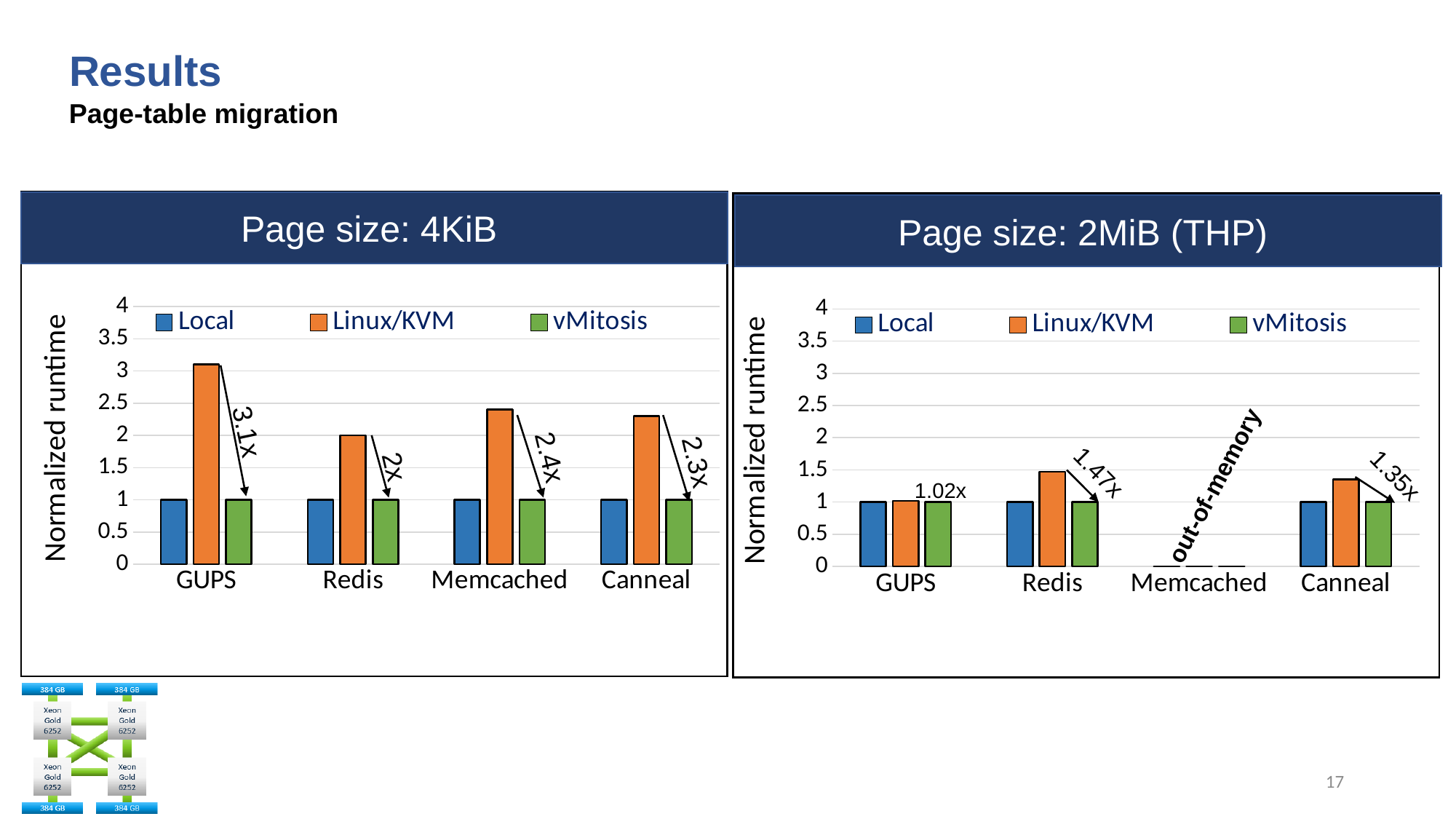
In the 'Page size: 2MiB (THP)' chart, which has the larger Linux/KVM normalized runtime, Redis or Canneal? Redis In the 'Page size: 4KiB' chart, how many series does the legend list? 3 In the 'Page size: 2MiB (THP)' chart, which category is marked 'out-of-memory' with no bars? Memcached In the 'Page size: 4KiB' chart, which category has the highest Linux/KVM normalized runtime? GUPS In the 'Page size: 4KiB' chart, is the Linux/KVM value for Memcached greater or less than 2? greater In the 'Page size: 4KiB' chart, what is the Local normalized runtime for GUPS? 1 In the 'Page size: 4KiB' chart, which category has the lowest Linux/KVM normalized runtime? Redis In the 'Page size: 4KiB' chart, what is the Linux/KVM normalized runtime for Redis? 2 What kind of chart is shown in the 'Page size: 4KiB' panel? bar chart In the 'Page size: 2MiB (THP)' chart, how many categories are shown on the x axis? 4 In the 'Page size: 2MiB (THP)' chart, is the Linux/KVM value for Canneal greater or less than 1.5? less In the 'Page size: 4KiB' chart, what speedup annotation is shown for GUPS? 3.1x